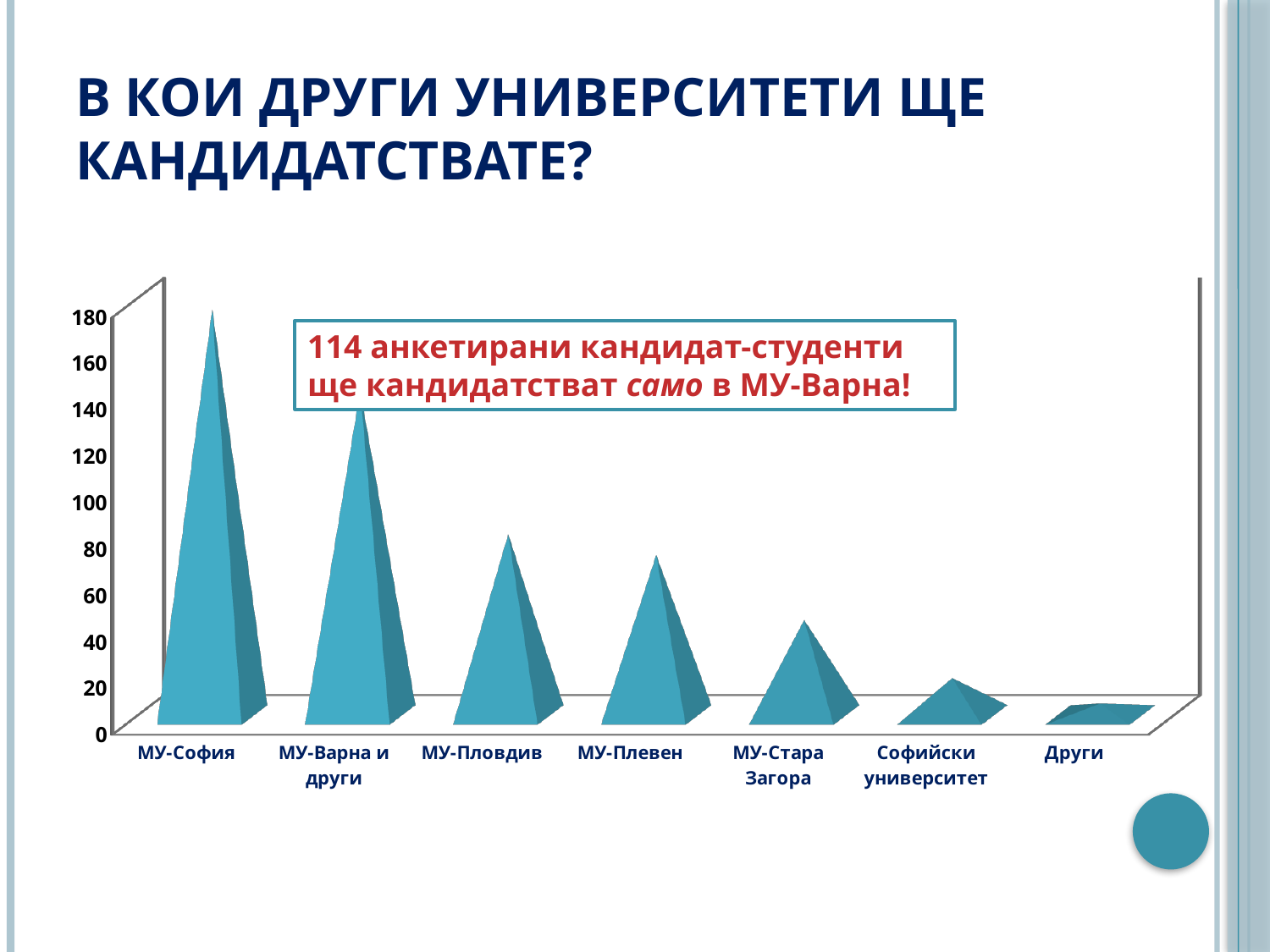
What kind of chart is shown on the slide? bar chart Is the value for МУ-Варна и други greater or less than 120? greater Which has a larger value, МУ-Стара Загора or Софийски университет? МУ-Стара Загора Which category has the highest value in the chart? МУ-София Is the value for МУ-София greater or less than 160? greater Is the value for Софийски университет greater or less than 40? less Which category has the lowest value in the chart? Други How many categories are shown on the x axis of the chart? 7 Which has a larger value, МУ-София or МУ-Варна и други? МУ-София Do the values rise or fall moving from left to right along the x axis? fall According to the text box on the chart, how many surveyed candidate students will apply only to МУ-Варна? 114